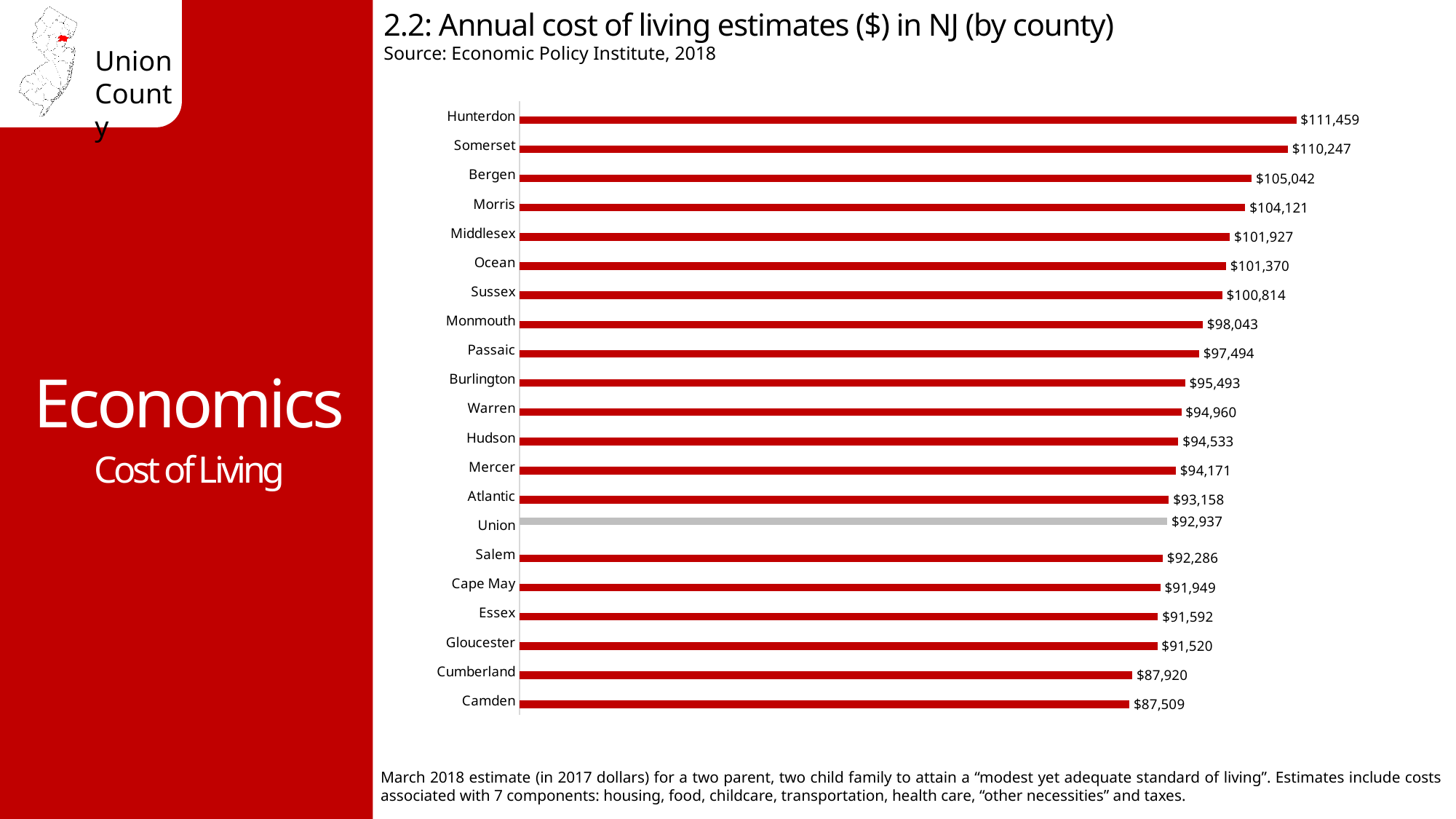
What is the annual cost of living estimate for Union county? $92,937 What is the annual cost of living estimate for Cumberland county? $87,920 What is the annual cost of living estimate for Bergen county? $105,042 What is the difference between the cost of living estimates for Hunterdon and Camden? $23,950 Which county has a higher cost of living estimate, Essex or Passaic? Passaic How many counties are shown in the chart? 21 What kind of chart is shown on the slide? Bar chart Which county has the lowest annual cost of living estimate? Camden Which county's bar is shown in grey instead of red? Union Which county has the highest annual cost of living estimate? Hunterdon Which county has a higher cost of living estimate, Morris or Monmouth? Morris What is the difference between the cost of living estimates for Union and Camden? $5,428